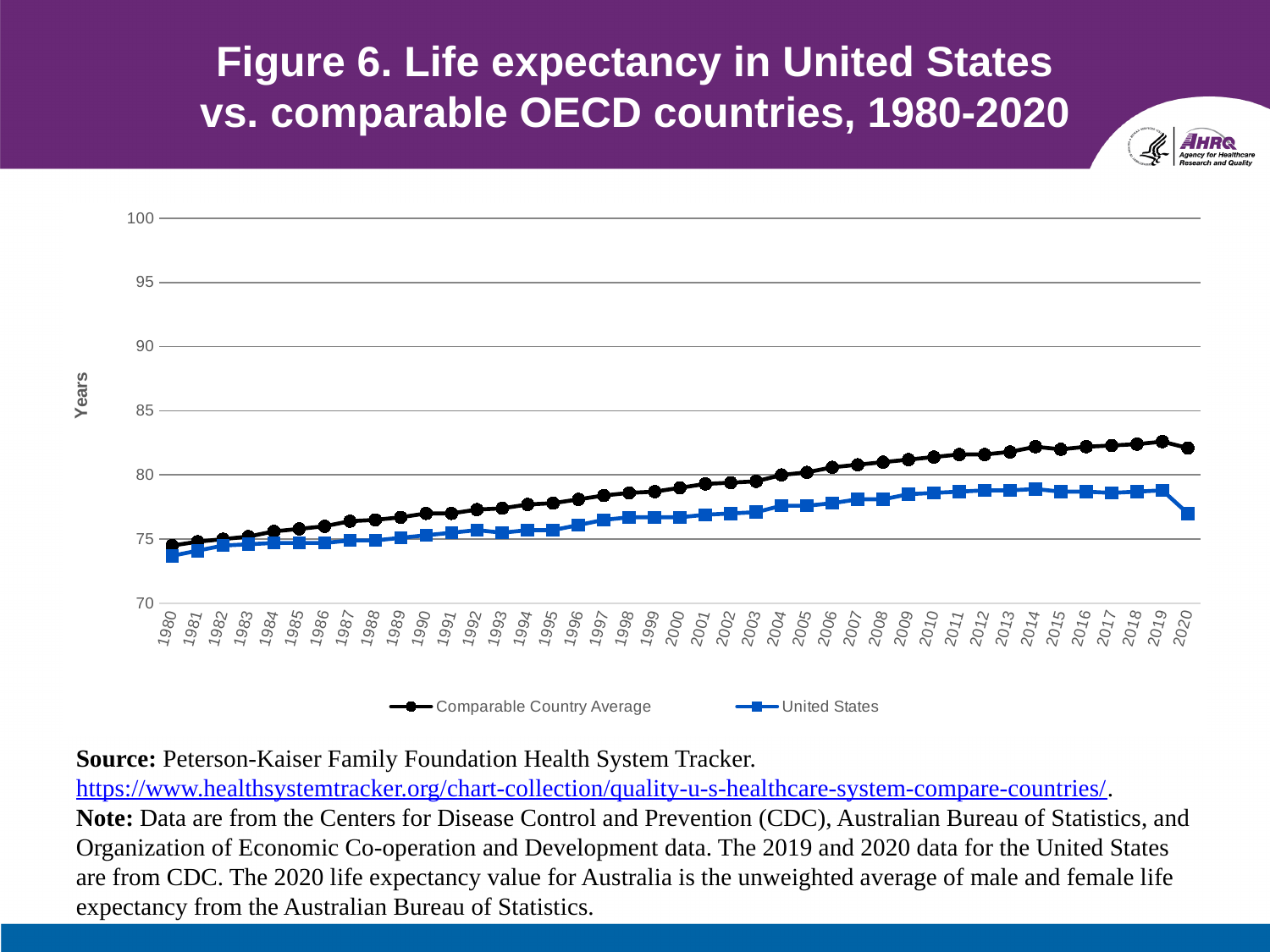
What is the title of the chart? Figure 6. Life expectancy in United States vs. comparable OECD countries, 1980-2020 Is the value for United States in 2020 greater or less than 80? less Does the Comparable Country Average line generally rise or fall from 1980 to 2019? Rise Is the value for Comparable Country Average in 2020 greater or less than 80? greater What kind of chart is shown on the slide? Line chart Is the value for Comparable Country Average in 2019 greater or less than 85? less Which series is higher in 2020, Comparable Country Average or United States? Comparable Country Average What is the label on the y axis? Years How many series does the legend list? 2 How many years are plotted along the x axis? 41